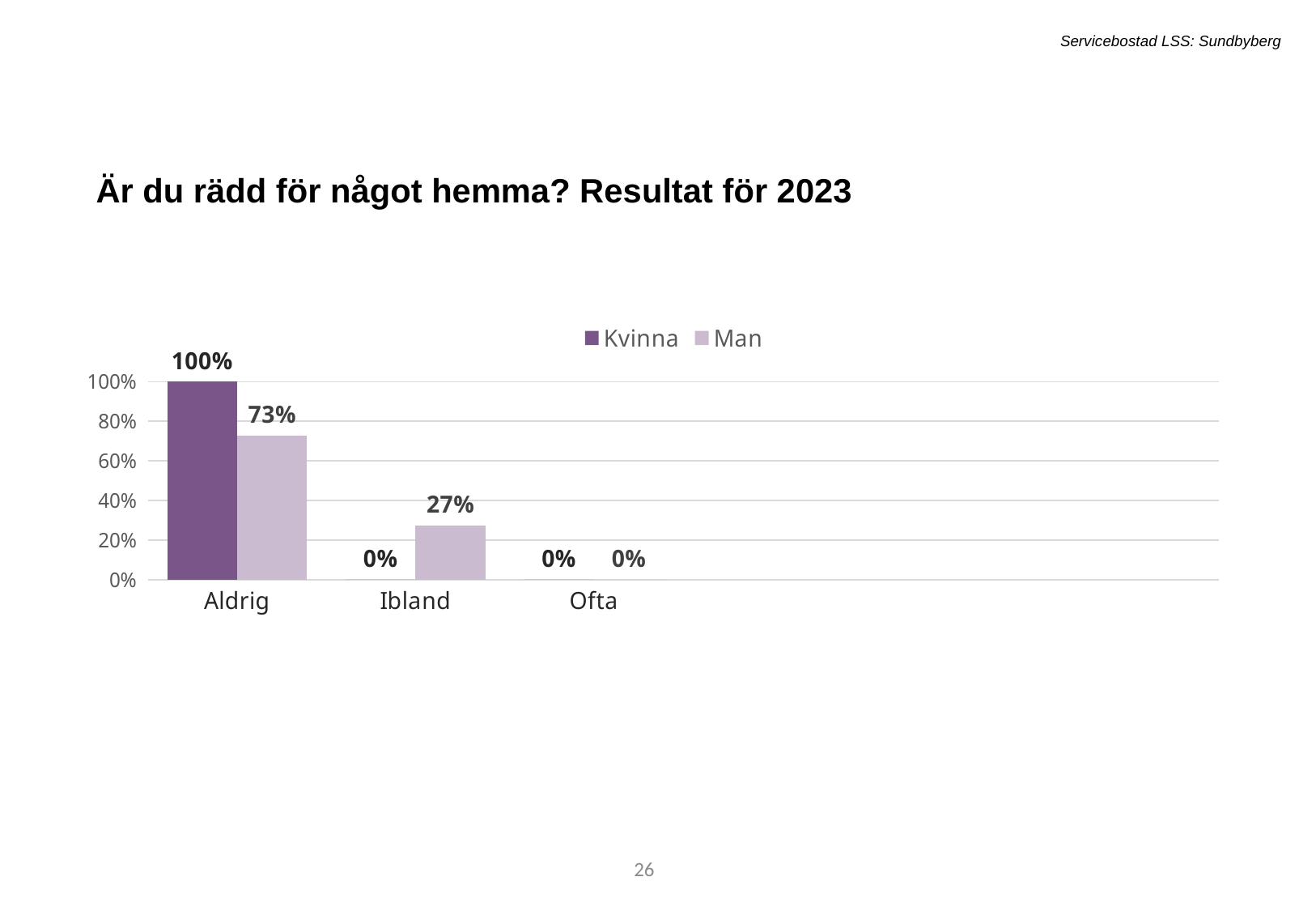
What is the difference between the Man values for Aldrig and Ibland? 46% What kind of chart is shown on the slide? Bar chart How many categories are shown on the x axis? 3 What is the difference between the Kvinna and Man values in the Aldrig category? 27% What are the two series named in the legend? Kvinna and Man How many series does the legend list? 2 Which category has the highest value for Man? Aldrig What is the value for Kvinna in the Aldrig category? 100% What is the value for Man in the Aldrig category? 73% Which is larger in the Aldrig category, Kvinna or Man? Kvinna What is the value for Kvinna in the Ibland category? 0% What is the value for Man in the Ibland category? 27%